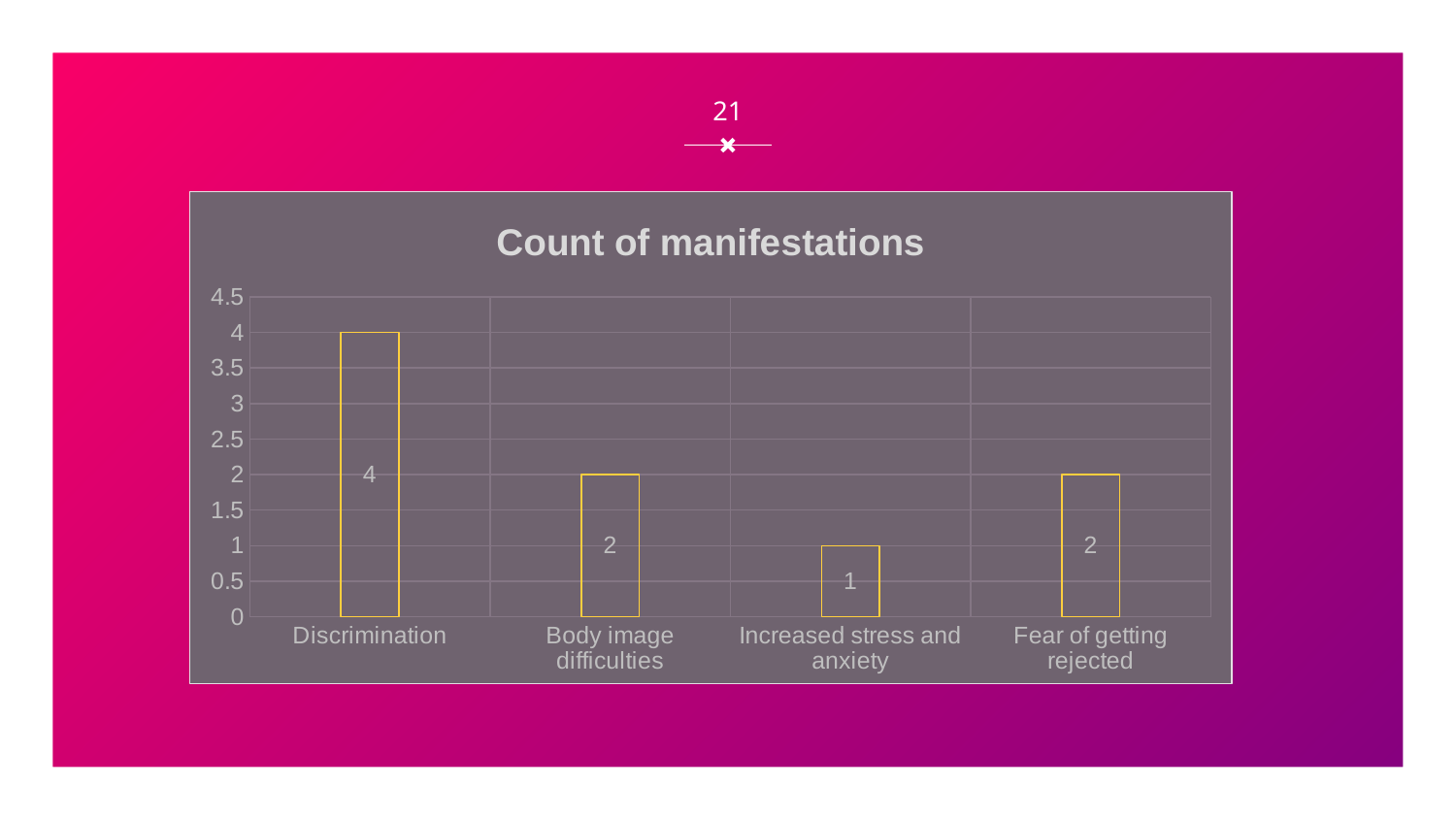
What is the value for Increased stress and anxiety? 1 Which category has the highest value? Discrimination What is the value for Fear of getting rejected? 2 What is the value for Body image difficulties? 2 What is the title of the chart? Count of manifestations What is the value for Discrimination? 4 Which category has the lowest value? Increased stress and anxiety How many categories are shown on the x axis? 4 What is the difference between the values for Discrimination and Increased stress and anxiety? 3 What is the difference between the values for Discrimination and Body image difficulties? 2 Which is larger, the value for Discrimination or the value for Fear of getting rejected? Discrimination Is the value for Discrimination greater or less than 3? greater